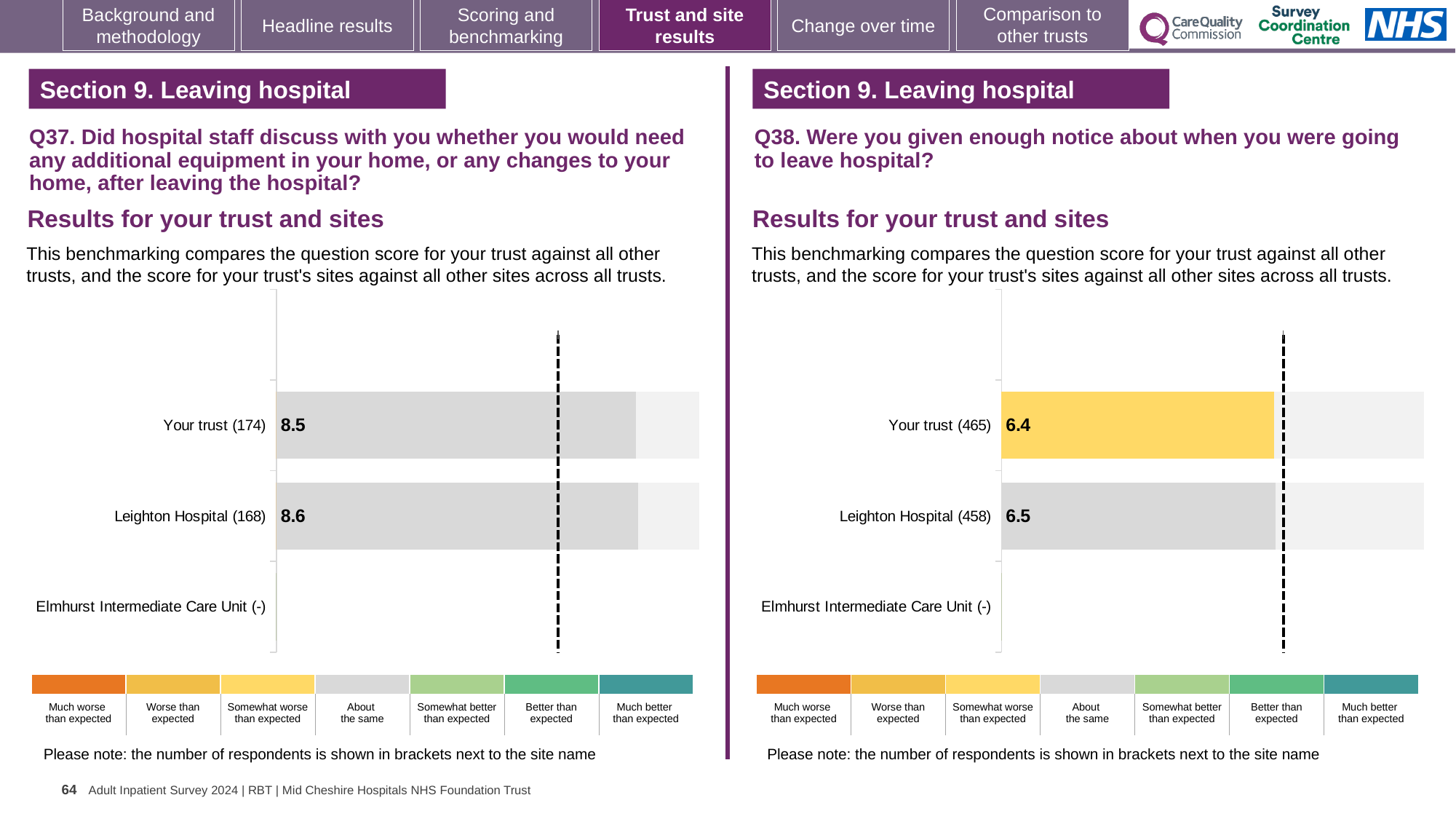
In the Q37 chart on the left, what is the score for Leighton Hospital? 8.6 What type of chart is used in the Q38 chart on the right? Bar chart In the Q37 chart on the left, what is the score for Your trust? 8.5 In the Q38 chart on the right, what is the score for Your trust? 6.4 In the Q38 chart on the right, which has the higher score, Your trust or Leighton Hospital? Leighton Hospital In the Q38 chart on the right, what is the score for Leighton Hospital? 6.5 In the Q38 chart on the right, which benchmark category does the colour of the Your trust bar correspond to in the legend? Somewhat worse than expected In the Q37 chart on the left, how many respondents are shown in brackets for Leighton Hospital? 168 In the Q38 chart on the right, what is the difference between the Leighton Hospital score and the Your trust score? 0.1 How many site/trust categories are listed on the y axis of the Q37 chart on the left? 3 In the Q37 chart on the left, what is the difference between the Leighton Hospital score and the Your trust score? 0.1 In the Q38 chart on the right, how many respondents are shown in brackets for Your trust? 465